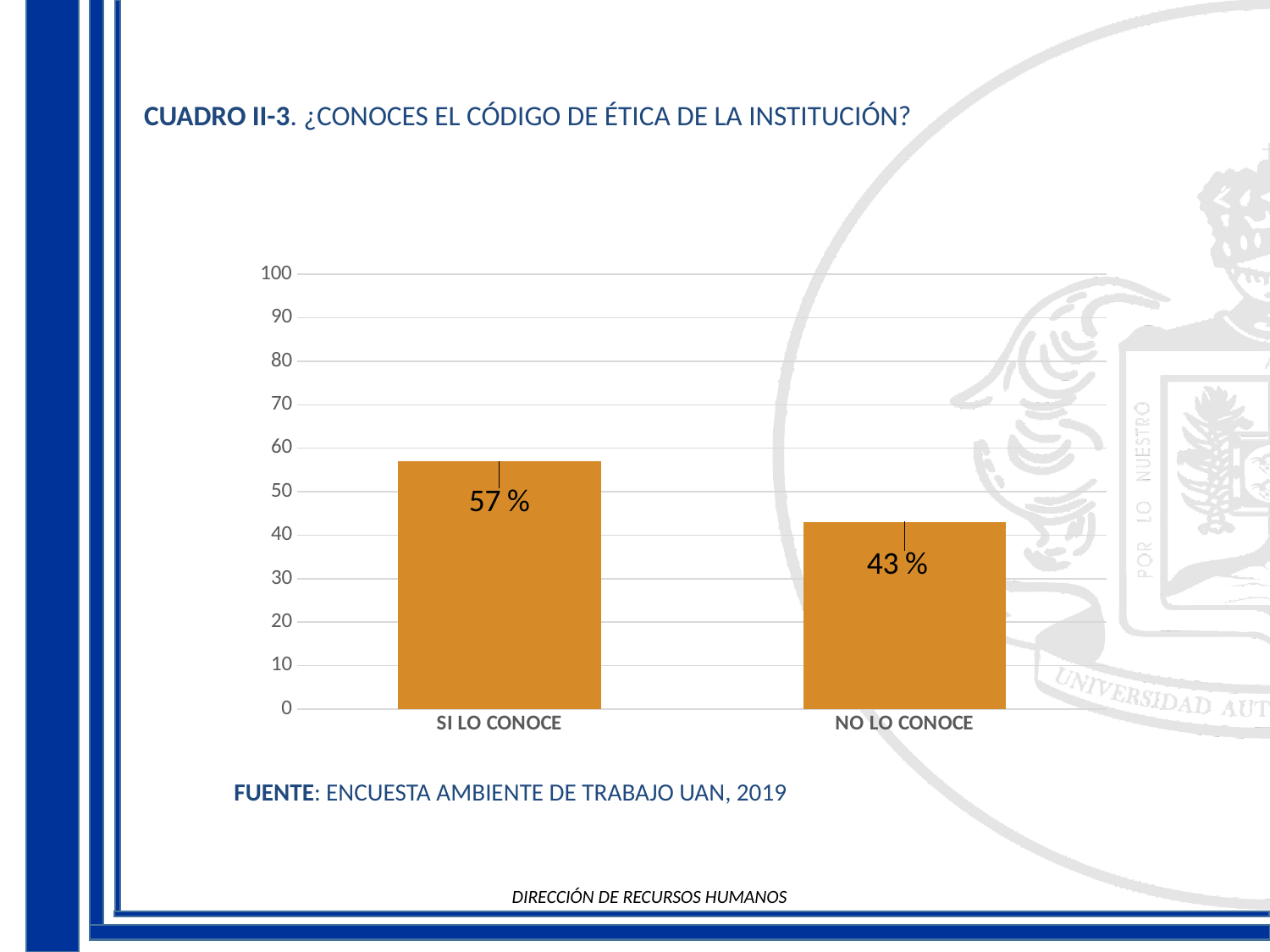
Which category has the highest value? SI LO CONOCE What is the difference between the values for SI LO CONOCE and NO LO CONOCE? 14 % What is the title of the chart on the slide? CUADRO II-3. ¿CONOCES EL CÓDIGO DE ÉTICA DE LA INSTITUCIÓN? Which is larger, the value for SI LO CONOCE or NO LO CONOCE? SI LO CONOCE What is the value for SI LO CONOCE? 57 % Which category has the lowest value? NO LO CONOCE What kind of chart is shown on the slide? bar chart Is the value for SI LO CONOCE greater or less than 50? greater Is the value for NO LO CONOCE greater or less than 50? less What is the value for NO LO CONOCE? 43 % What is the maximum value shown on the y axis? 100 How many categories are shown on the x axis? 2